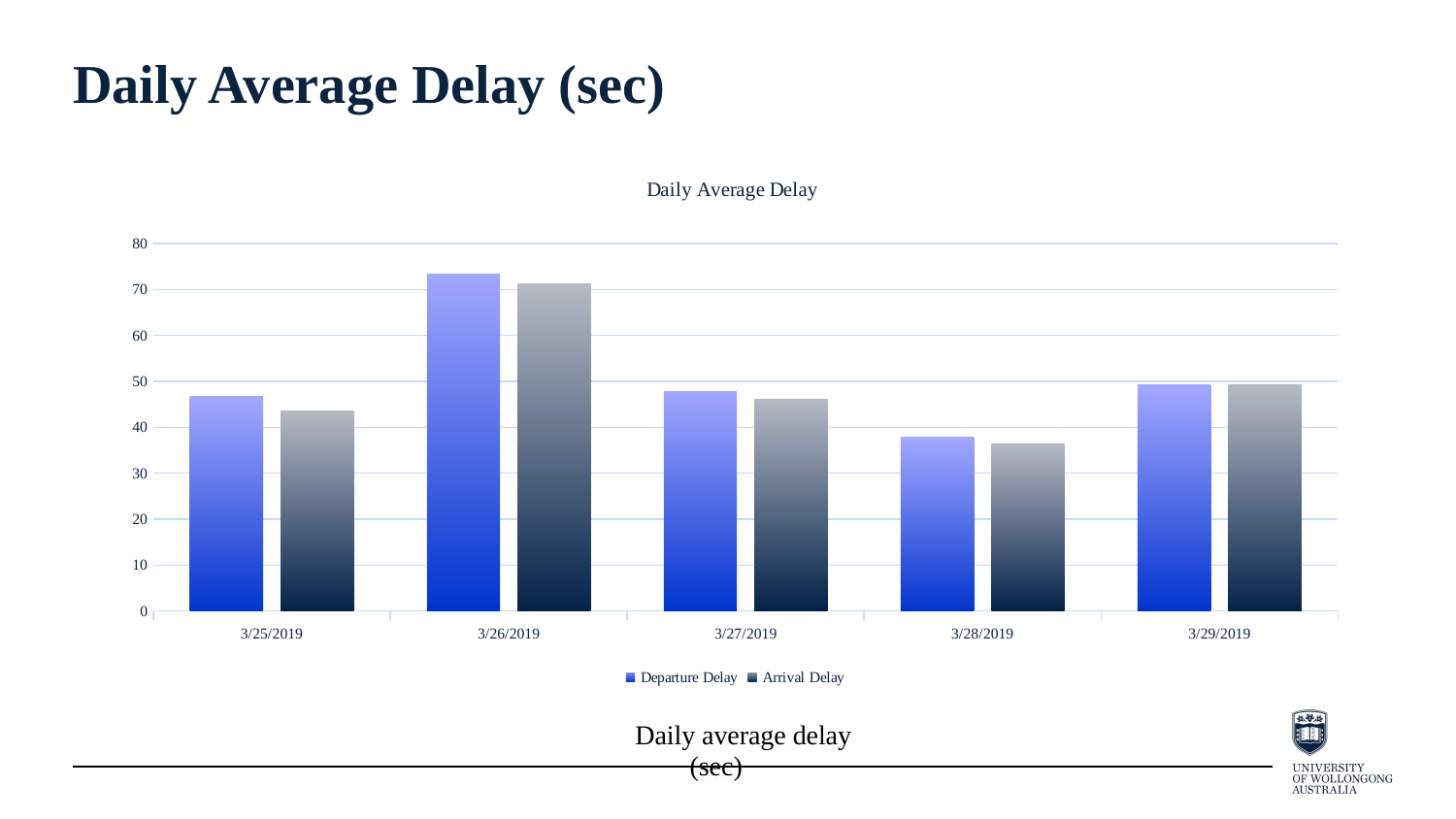
What is the title shown above the chart? Daily Average Delay Which date has the lowest Arrival Delay? 3/28/2019 Which date has the lowest Departure Delay? 3/28/2019 On 3/25/2019, which is larger: Departure Delay or Arrival Delay? Departure Delay Is the Departure Delay for 3/26/2019 greater or less than 70? greater How many series does the chart's legend list? 2 Which date has the highest Departure Delay? 3/26/2019 What kind of chart is shown on the slide? bar chart How many dates are shown on the x axis of the chart? 5 Is the Arrival Delay for 3/28/2019 greater or less than 40? less Which is larger: the Departure Delay on 3/26/2019 or on 3/28/2019? 3/26/2019 Is the Departure Delay for 3/25/2019 greater or less than 50? less